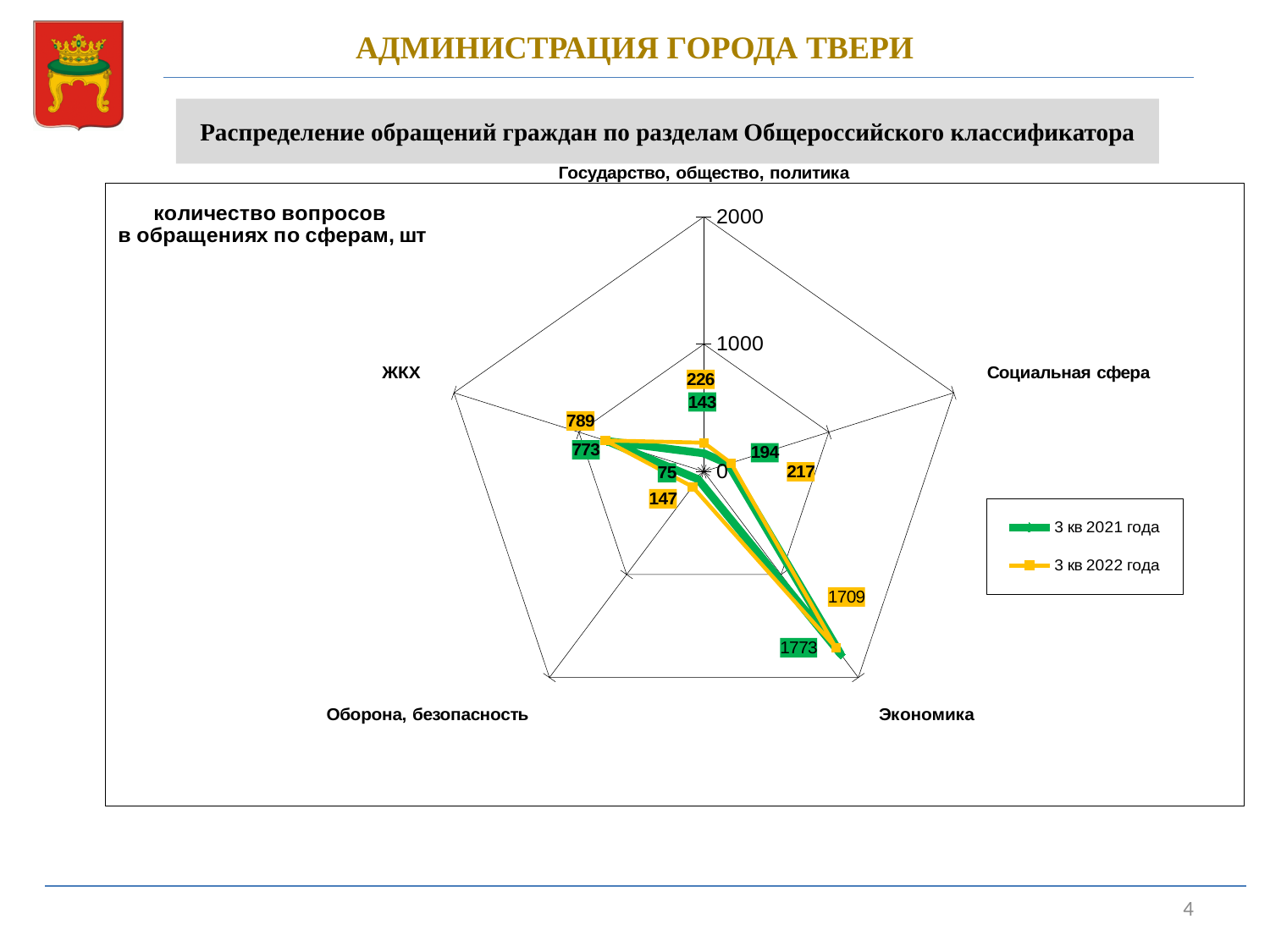
Which category has the lowest value in 3 кв 2022 года? Оборона, безопасность What kind of chart is shown on the slide? Radar chart How many categories (axes) does the radar chart have? 5 How many series does the legend list? 2 Which is larger for Государство, общество, политика: the 3 кв 2021 года value or the 3 кв 2022 года value? 3 кв 2022 года What is the value for Оборона, безопасность in 3 кв 2021 года? 75 What is the difference between the 3 кв 2021 года and 3 кв 2022 года values for Экономика? 64 Which category has the highest value in 3 кв 2022 года? Экономика What is the value for Экономика in 3 кв 2022 года? 1709 Which colour represents the series 3 кв 2021 года? Green What is the value for ЖКХ in 3 кв 2022 года? 789 What is the value for Экономика in 3 кв 2021 года? 1773